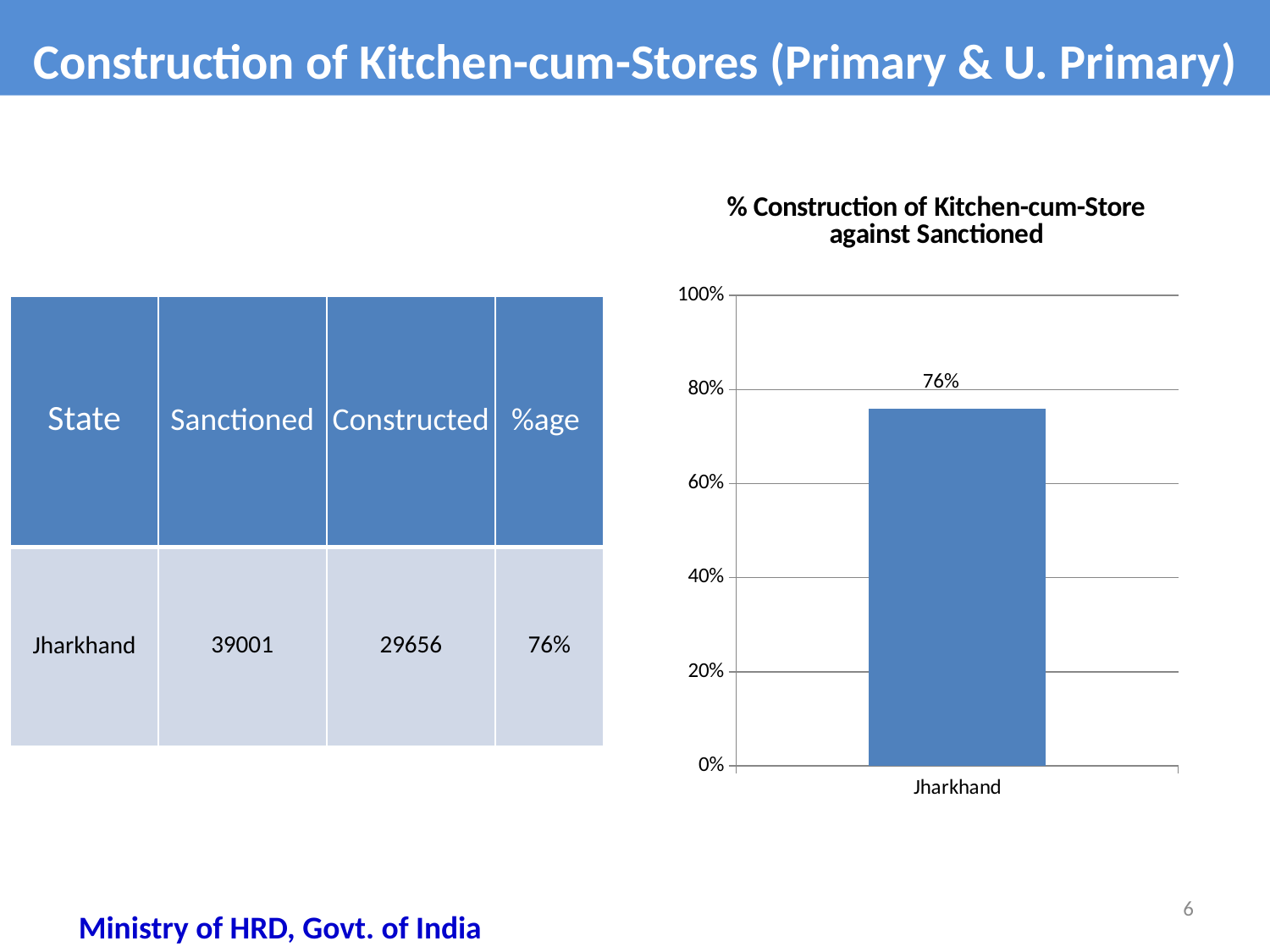
What is the title of the chart? % Construction of Kitchen-cum-Store against Sanctioned What kind of chart is shown on the slide? bar chart Which state is shown on the chart's x axis? Jharkhand Is the value for Jharkhand greater or less than 80%? less What is the value for Jharkhand in the chart? 76% How many categories are plotted in the chart? 1 What is the highest value shown on the chart's vertical axis? 100% Is the value for Jharkhand greater or less than 60%? greater